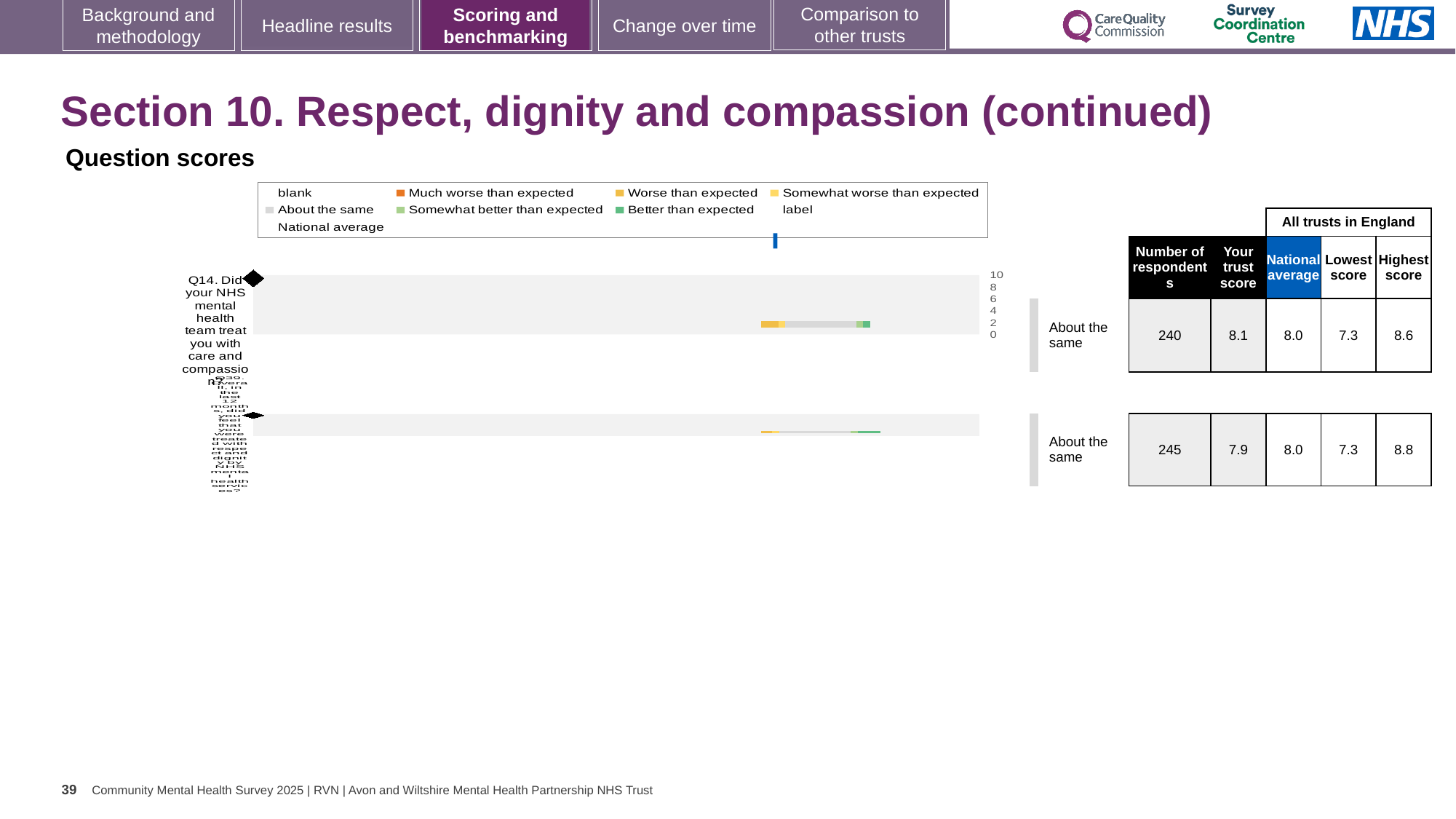
What is the national average score for Q14 in the table beside the chart? 8.0 What benchmark category is shown for Q39 next to the chart? About the same How many respondents answered Q39 according to the table beside the chart? 245 What is the highest tick value shown on the chart's score axis? 10 What colour is the legend marker for 'Much worse than expected'? orange How many questions (categories) are plotted in the chart? 2 What is the difference between the highest score and the lowest score for Q14 in the table? 1.3 How many entries does the chart legend list? 9 Which question has the higher trust score, Q14 or Q39? Q14 How many respondents answered Q14 according to the table beside the chart? 240 What kind of chart is shown on the slide? bar chart What is the trust score for Q14 (care and compassion) in the table beside the chart? 8.1